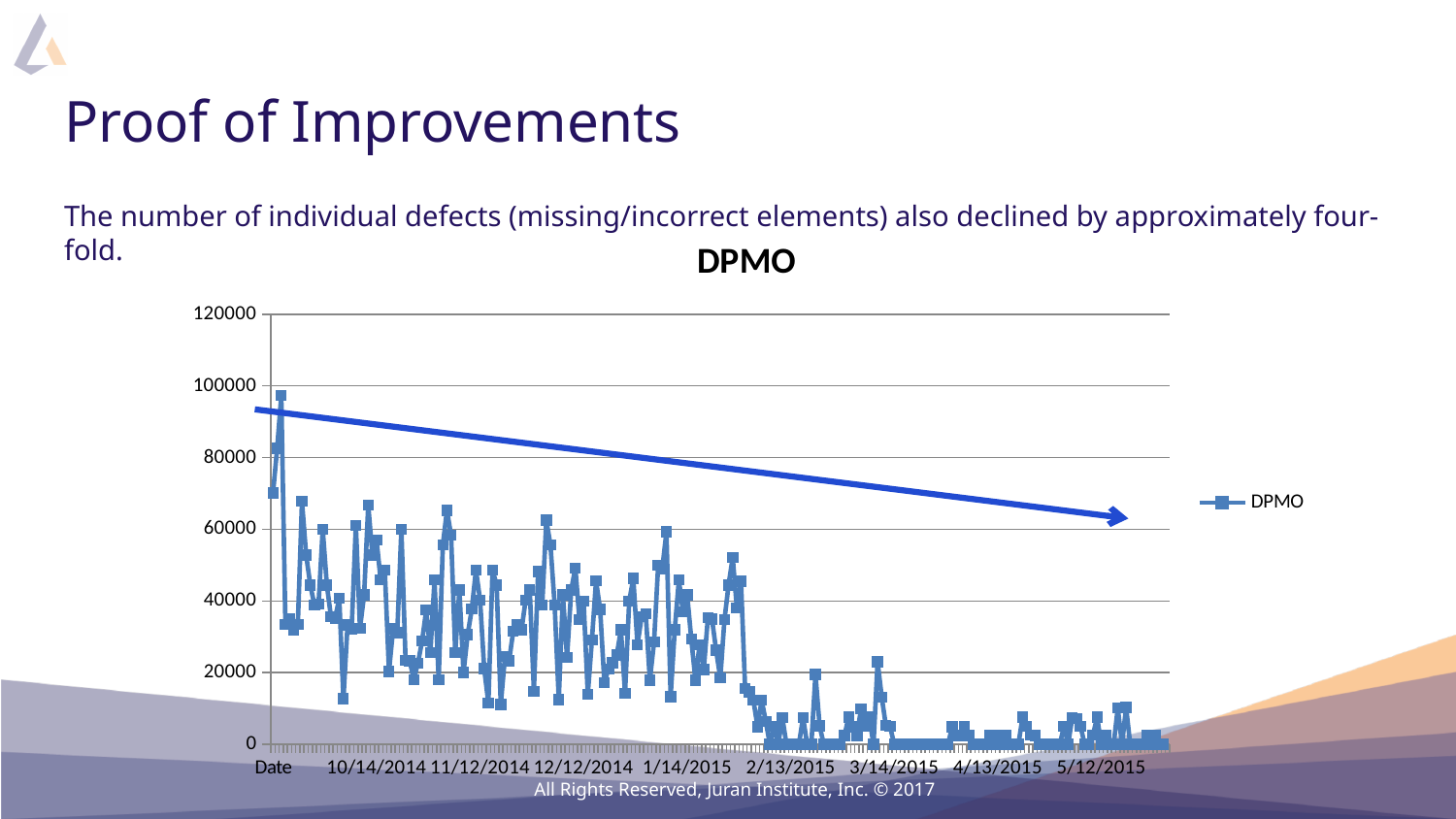
Which period has higher DPMO values: around 11/12/2014 or around 4/13/2015? around 11/12/2014 What kind of chart is shown on the slide? line chart What is the last date label shown on the x axis? 5/12/2015 What is the name of the series shown in the legend? DPMO Do the DPMO values generally rise or fall over time along the x axis? fall Are the DPMO values around 4/13/2015 greater or less than 40000? less Is the highest DPMO value on the chart greater or less than 100000? less What is the maximum value shown on the vertical axis? 120000 How many series does the legend list? 1 Is the highest DPMO value on the chart greater or less than 80000? greater What is the title of the chart? DPMO